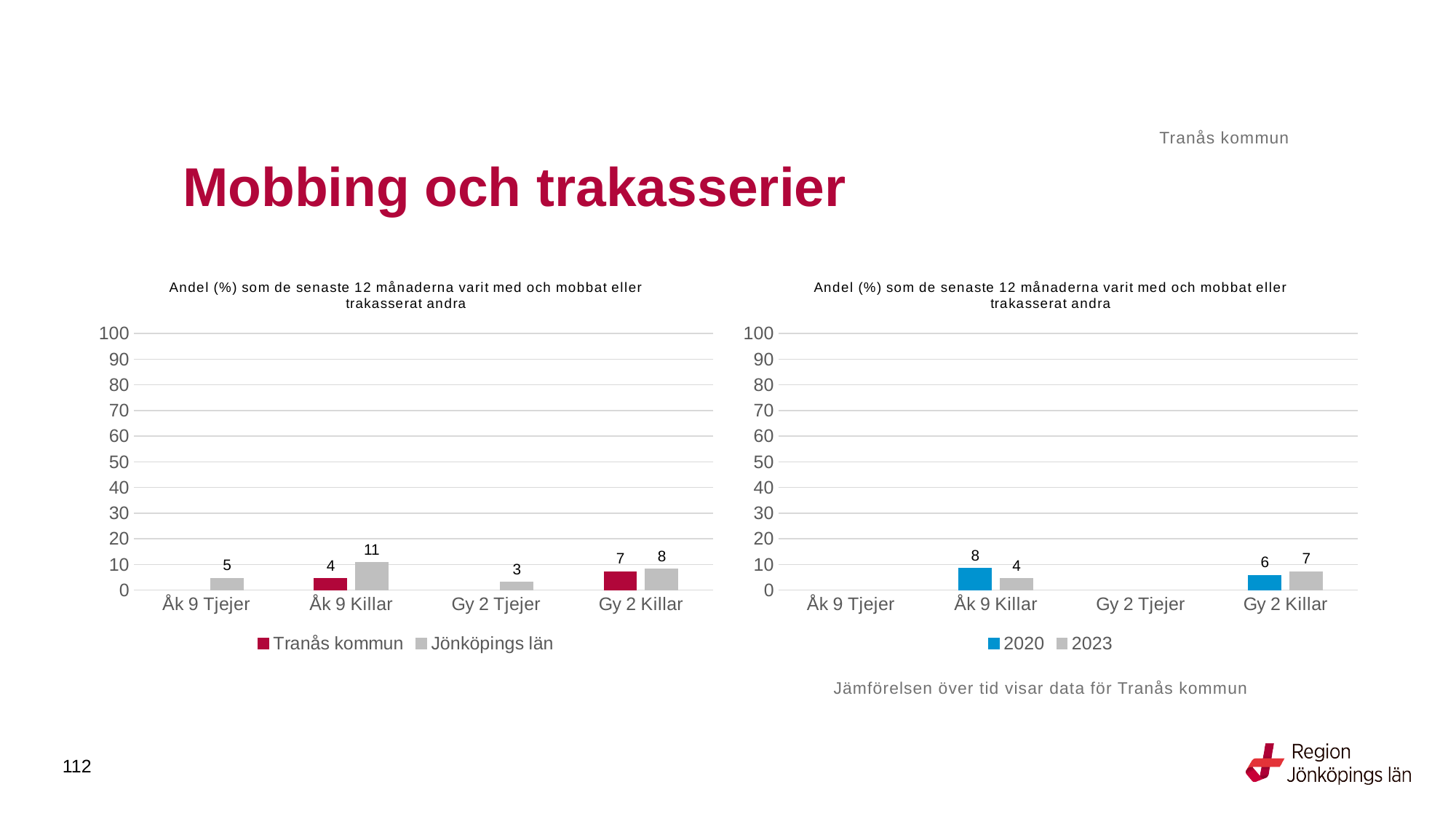
In the right chart, what is the value for 2020 for Åk 9 Killar? 8 In the right chart, what is the value for 2023 for Gy 2 Killar? 7 What type of chart is the left chart? Bar chart In the left chart, which category has the highest value for Jönköpings län? Åk 9 Killar In the left chart, what is the value for Tranås kommun for Gy 2 Killar? 7 In the left chart, what is the difference between Jönköpings län and Tranås kommun for Åk 9 Killar? 7 In the left chart, what is the value for Jönköpings län for Åk 9 Killar? 11 In the left chart, what is the value for Jönköpings län for Gy 2 Tjejer? 3 How many series does the legend of the right chart list? 2 In the left chart, which is larger for Gy 2 Killar: Tranås kommun or Jönköpings län? Jönköpings län In the right chart, which is larger for Gy 2 Killar: 2020 or 2023? 2023 In the right chart, what is the difference between 2020 and 2023 for Åk 9 Killar? 4